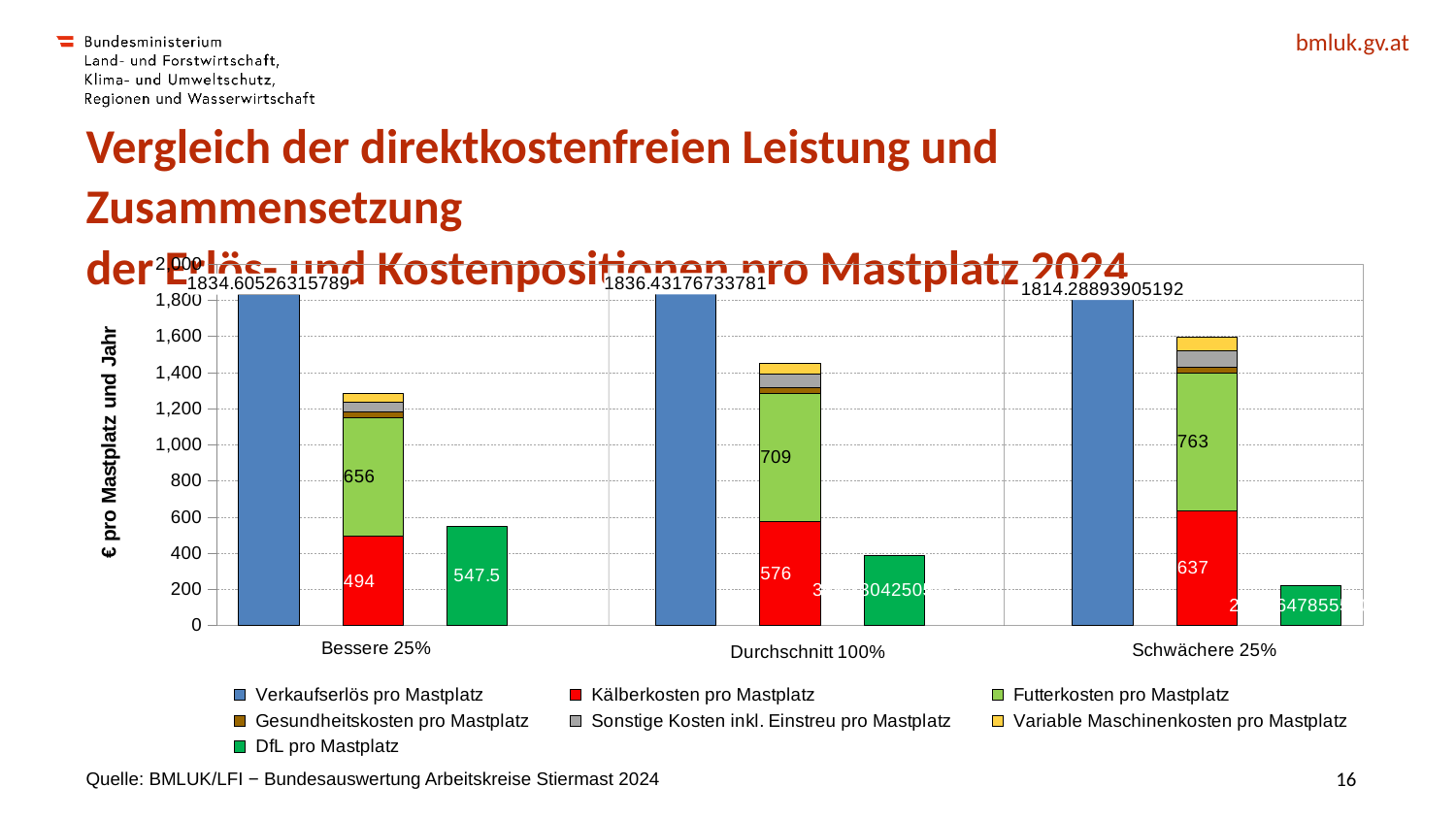
What is the value of Futterkosten pro Mastplatz for Durchschnitt 100%? 709 What is the difference in Futterkosten pro Mastplatz between Schwächere 25% and Bessere 25%? 107 What is the value of Verkaufserlös pro Mastplatz for Schwächere 25%? 1814.28893905192 How many series does the chart legend list? 7 Is the value of DfL pro Mastplatz for Schwächere 25% greater or less than 400? less What is the label of the y axis of the chart? € pro Mastplatz und Jahr What is the value of Kälberkosten pro Mastplatz for Bessere 25%? 494 Which category has the highest Kälberkosten pro Mastplatz? Schwächere 25% What is the value of DfL pro Mastplatz for Bessere 25%? 547.5 How many categories are shown on the x axis of the chart? 3 What kind of chart is shown on the slide? bar chart Which category has the lowest Futterkosten pro Mastplatz? Bessere 25%